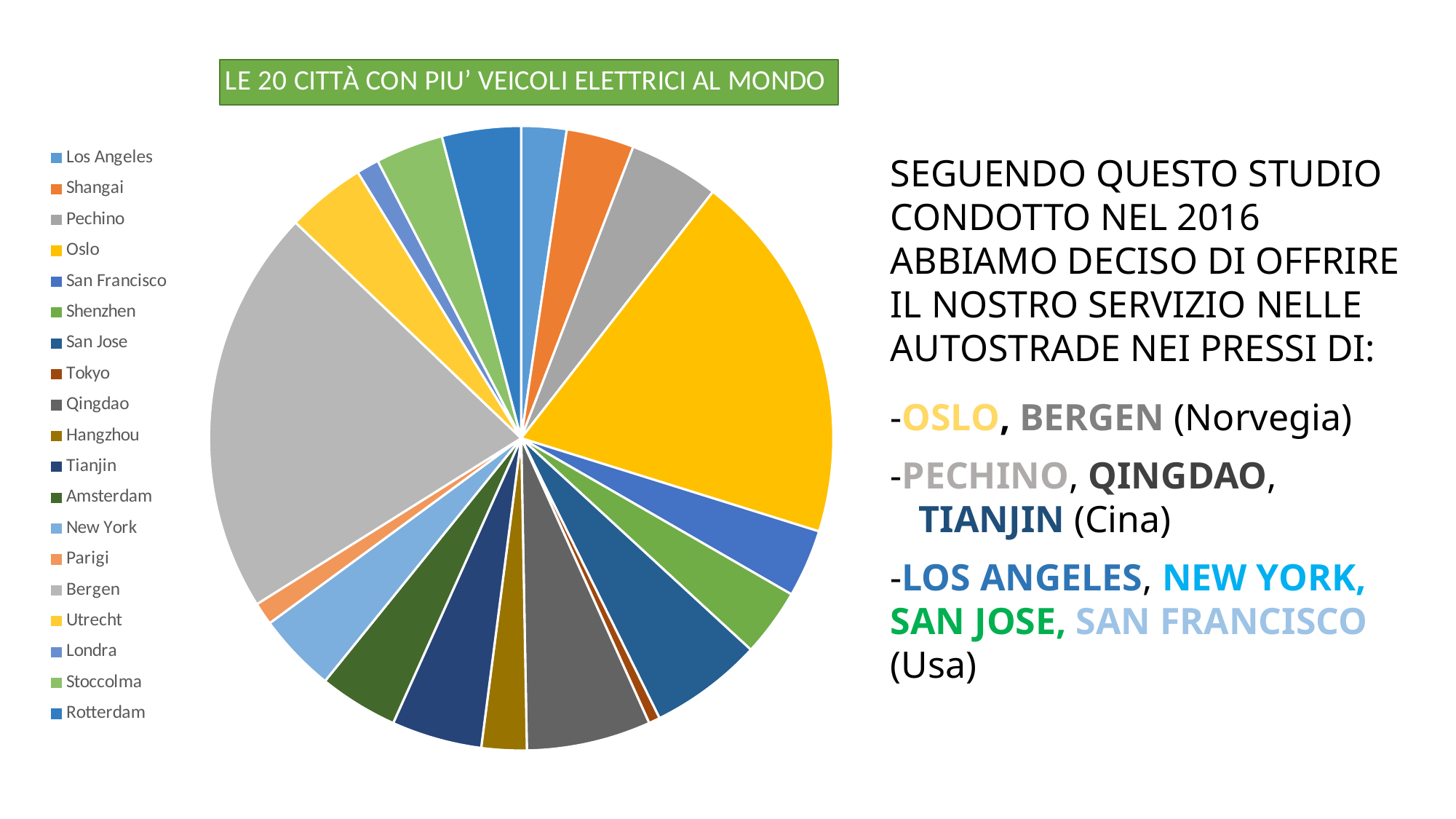
How many cities (slices) does the pie chart show? 19 How many series does the chart's legend list? 1 Which city is listed first in the chart's legend? Los Angeles Which city has the largest slice of the pie chart? Bergen Which slice is larger, Bergen or Los Angeles? Bergen Which slice is larger, Pechino or Tokyo? Pechino What is the title of the pie chart? LE 20 CITTÀ CON PIU' VEICOLI ELETTRICI AL MONDO Which slice is larger, Qingdao or Londra? Qingdao What kind of chart is shown on the slide? pie chart Which city has the smallest slice of the pie chart? Tokyo